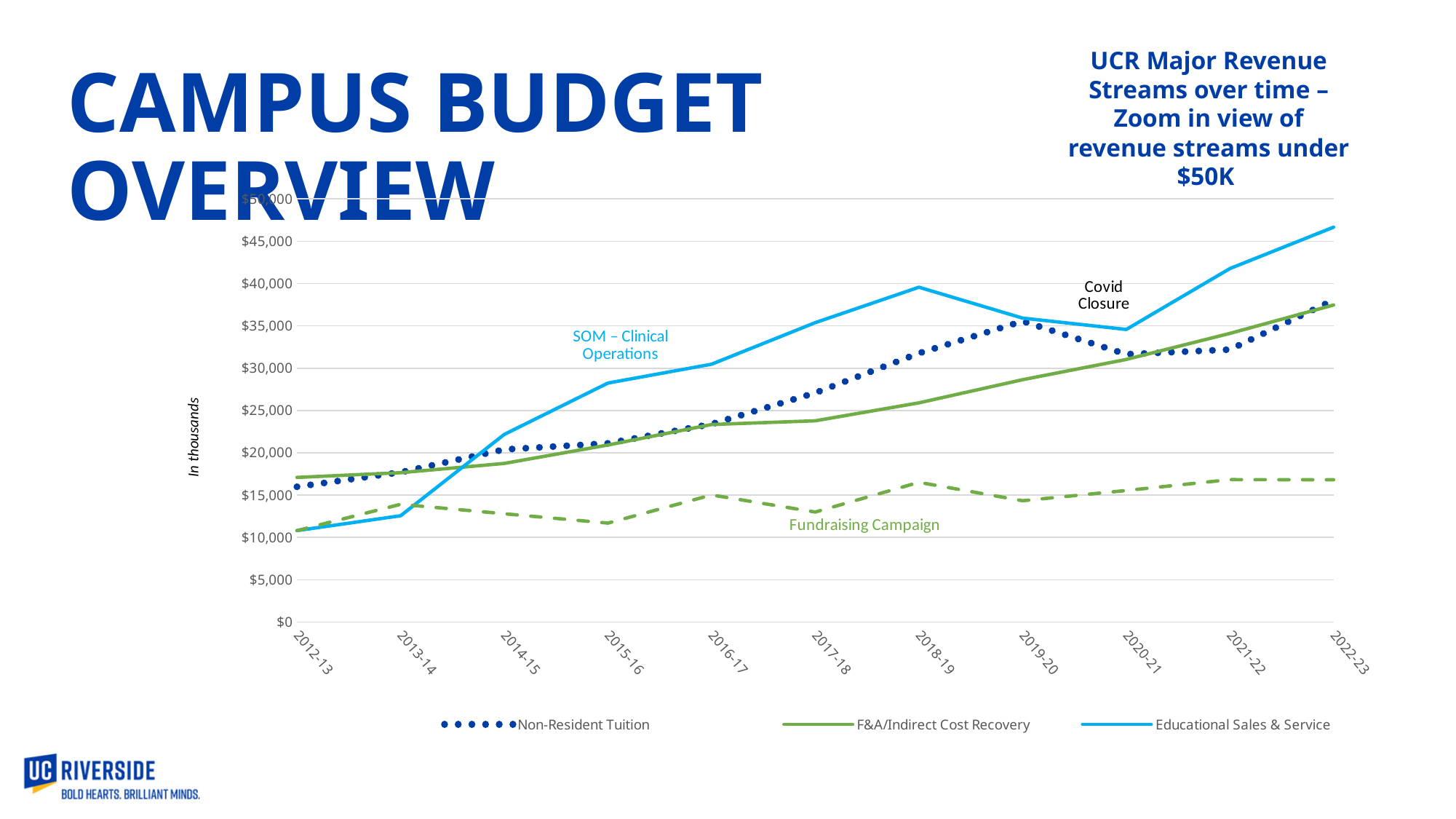
What event is annotated on the chart near 2019-20 and 2020-21? Covid Closure Is the value for Non-Resident Tuition in 2019-20 greater or less than $30,000? greater Is the value for the Fundraising Campaign line in 2015-16 greater or less than $15,000? less In 2012-13, which is larger: F&A/Indirect Cost Recovery or Educational Sales & Service? F&A/Indirect Cost Recovery How many fiscal years are shown along the x axis of the chart? 11 In 2022-23, which is larger: Educational Sales & Service or Non-Resident Tuition? Educational Sales & Service In which year is Educational Sales & Service at its highest? 2022-23 Is the value for Educational Sales & Service in 2012-13 greater or less than $15,000? less Does Educational Sales & Service generally rise or fall from 2012-13 to 2022-23? Rise How many series does the chart legend list? 3 What kind of chart is shown on the slide? Line chart